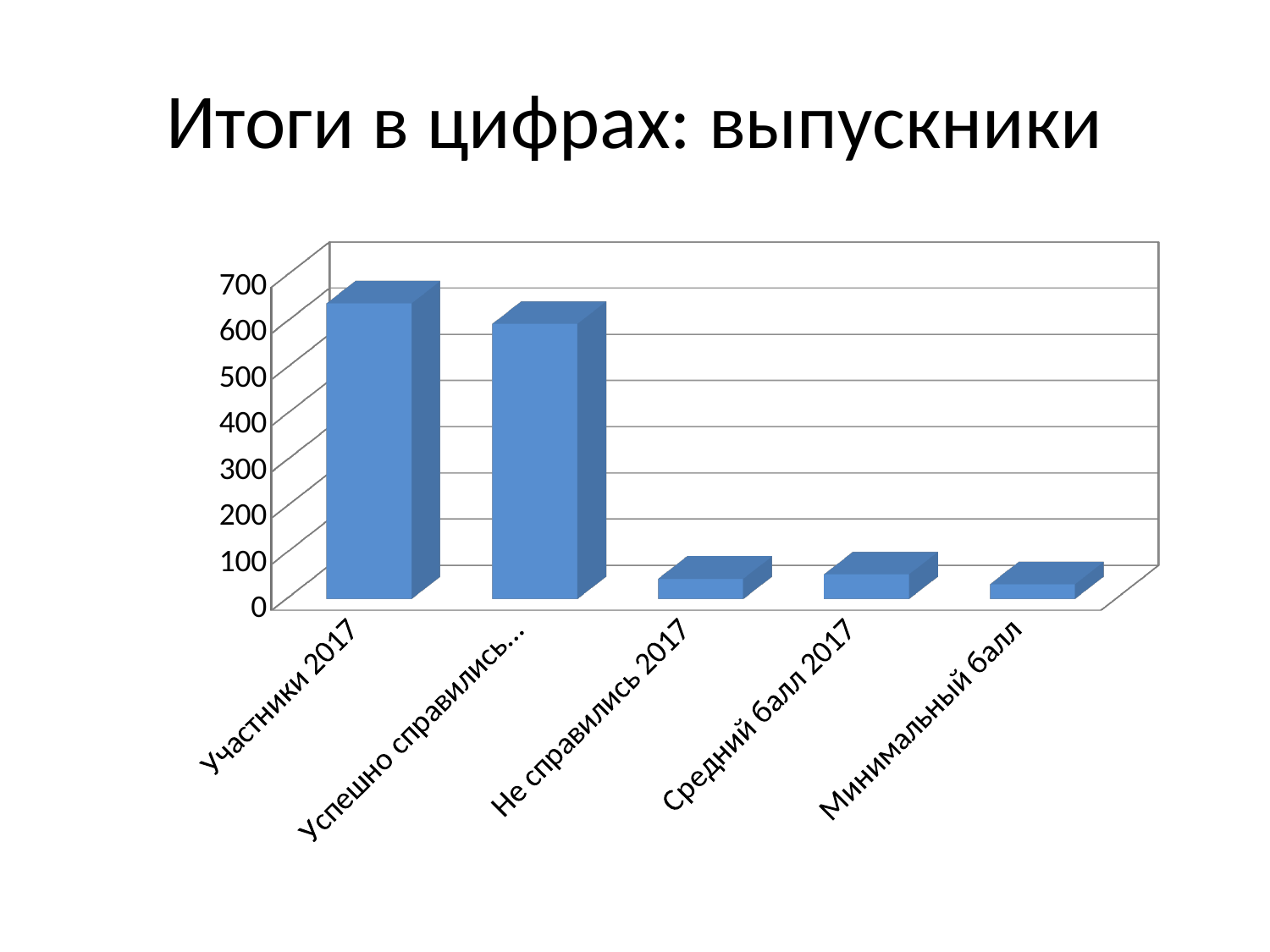
How many categories are shown on the x axis of the chart? 5 Is the value for Успешно справились… greater or less than 500? greater Is the value for Минимальный балл greater or less than 100? less What kind of chart is shown on the slide? bar chart Is the value for Участники 2017 greater or less than 600? greater What is the title of the slide with the chart? Итоги в цифрах: выпускники Which is larger, the value for Средний балл 2017 or the value for Участники 2017? Участники 2017 Which is larger, the value for Участники 2017 or the value for Успешно справились…? Участники 2017 Which category has the highest value in the chart? Участники 2017